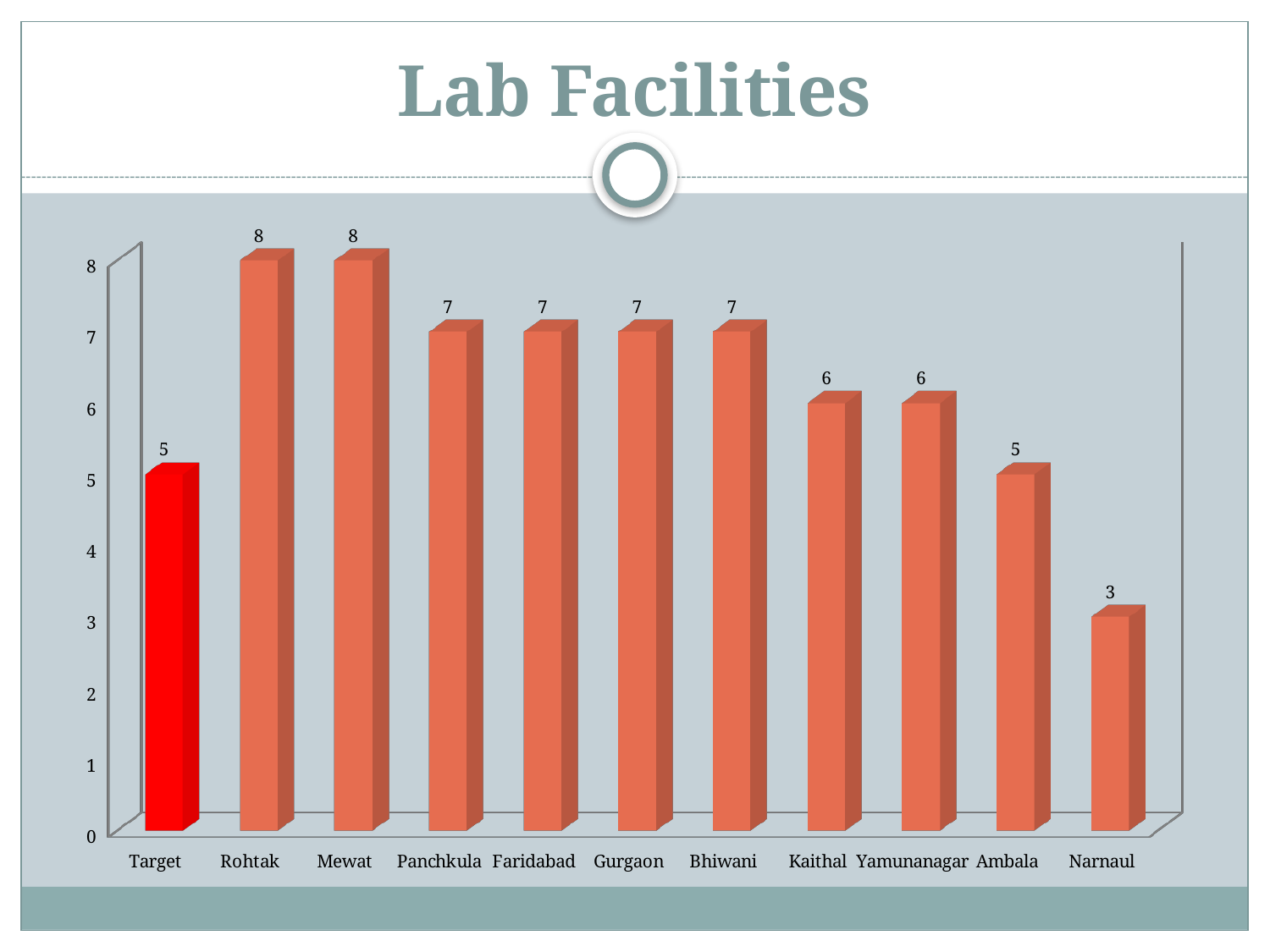
What is the difference between the values for Ambala and Target? 0 What is the value for Target? 5 What is the value for Narnaul? 3 What is the value for Kaithal? 6 What kind of chart is shown on the slide? bar chart Which category has the lowest value? Narnaul How many categories are shown on the x axis? 11 Which is larger, the value for Bhiwani or the value for Yamunanagar? Bhiwani What is the value for Panchkula? 7 What is the title of the slide? Lab Facilities Which bar is coloured differently (red) from the others? Target What is the difference between the values for Rohtak and Narnaul? 5